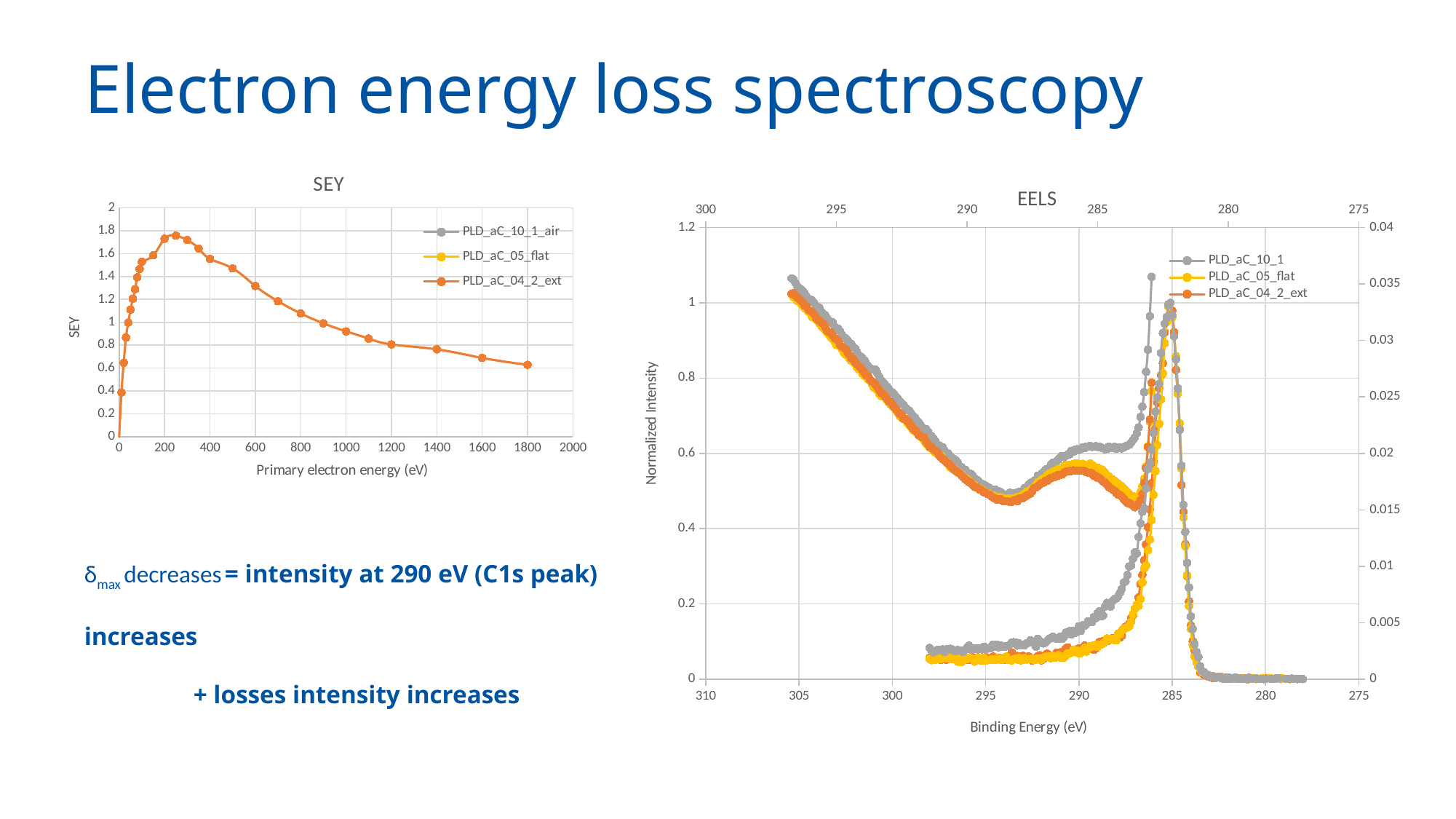
What is the x-axis label of the EELS chart? Binding Energy (eV) What is the x-axis label of the SEY chart? Primary electron energy (eV) In the EELS chart, at a binding energy of 290 eV, which series has the higher normalized intensity, PLD_aC_10_1 or PLD_aC_04_2_ext? PLD_aC_10_1 In the SEY chart, is the SEY value at a primary electron energy of 200 eV greater or less than 1.6? greater In the SEY chart, is the SEY value at a primary electron energy of 600 eV greater or less than 1.2? greater How many series does the legend of the SEY chart list? 3 In the SEY chart, do the SEY values rise or fall as the primary electron energy increases from 400 eV to 1800 eV? fall What kind of chart is the SEY chart on the left? line chart What kind of chart is the EELS chart on the right? line chart How many series does the legend of the EELS chart list? 3 In the SEY chart, is the SEY value at a primary electron energy of 1800 eV greater or less than 0.8? less